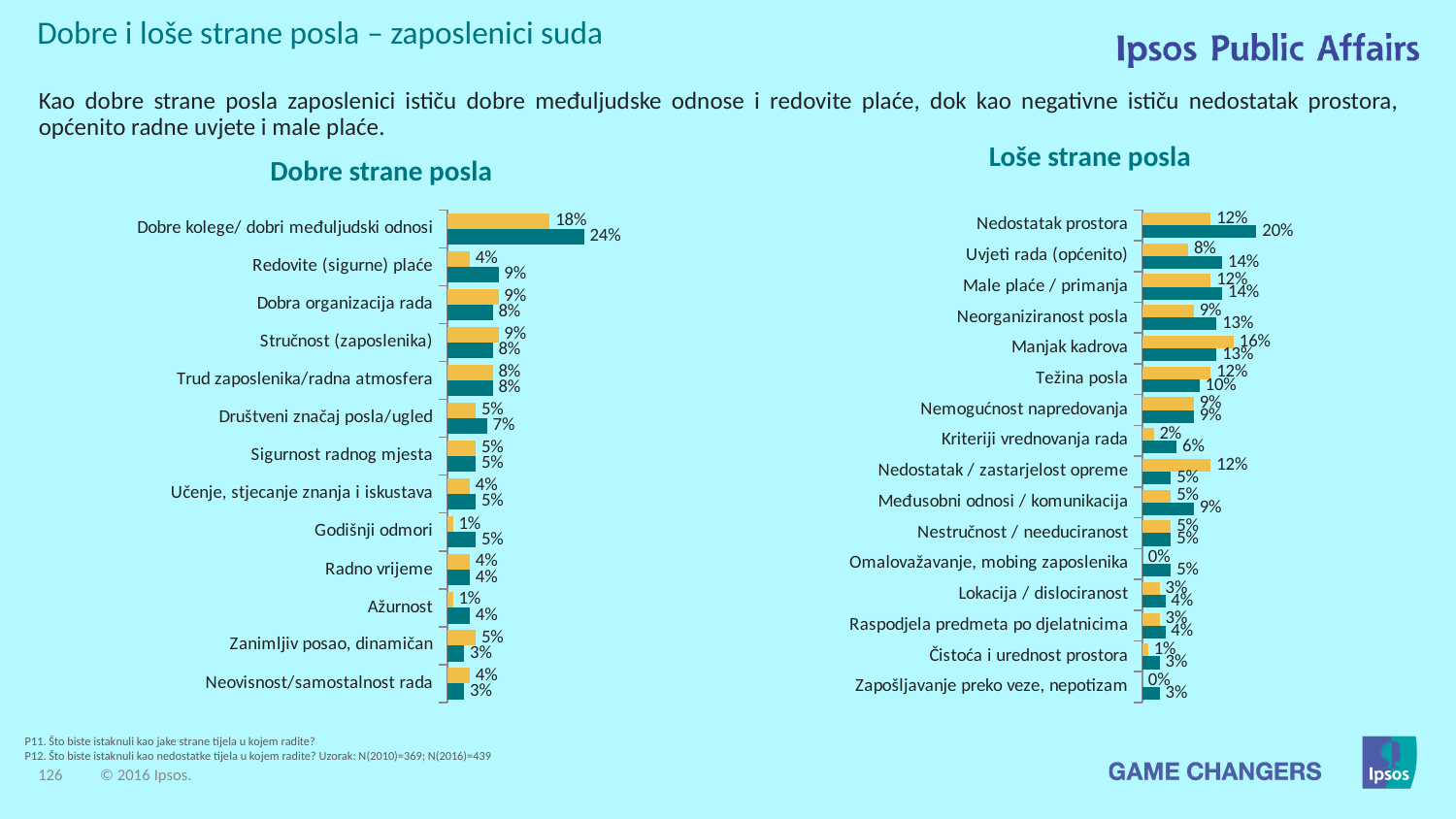
In the 'Dobre strane posla' chart, what is the value of the teal bar for 'Dobre kolege/ dobri međuljudski odnosi'? 24% In the 'Dobre strane posla' chart, which category has the highest teal bar value? Dobre kolege/ dobri međuljudski odnosi In the 'Loše strane posla' chart, what is the difference between the yellow and teal bar values for 'Nedostatak / zastarjelost opreme'? 7% In the 'Loše strane posla' chart, what is the value of the teal bar for 'Nedostatak prostora'? 20% In the 'Dobre strane posla' chart, what is the difference between the teal and yellow bar values for 'Redovite (sigurne) plaće'? 5% In the 'Loše strane posla' chart, which category has the highest yellow bar value? Manjak kadrova In the 'Dobre strane posla' chart, what is the value of the yellow bar for 'Godišnji odmori'? 1% How many categories are shown in the 'Dobre strane posla' chart? 13 In the 'Loše strane posla' chart, which is larger for 'Nedostatak / zastarjelost opreme': the yellow bar or the teal bar? the yellow bar What type of chart is the 'Loše strane posla' chart? bar chart How many categories are shown in the 'Loše strane posla' chart? 16 In the 'Loše strane posla' chart, what is the value of the yellow bar for 'Manjak kadrova'? 16%